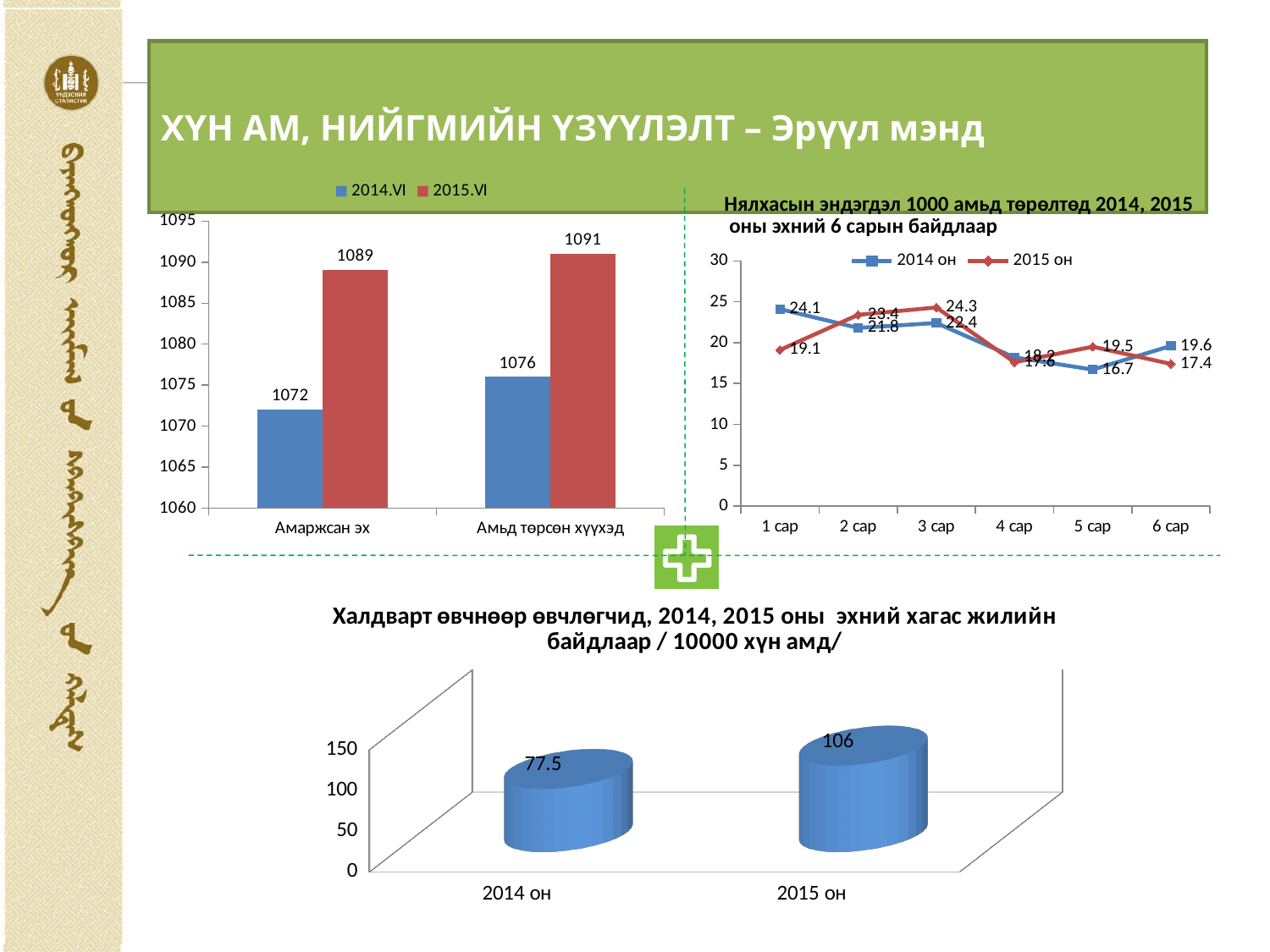
In the top-left bar chart, what is the 2015.VI value for Амаржсан эх? 1089 What kind of chart is the one titled 'Нялхасын эндэгдэл 1000 амьд төрөлтөд 2014, 2015 оны эхний 6 сарын байдлаар'? line chart In the top-left bar chart, how many series does the legend list? 2 In the top-left bar chart, what is the 2014.VI value for Амьд төрсөн хүүхэд? 1076 In the chart titled 'Халдварт өвчнөөр өвчлөгчид, 2014, 2015 оны эхний хагас жилийн байдлаар / 10000 хүн амд/', what is the value for 2015 он? 106 In the chart titled 'Нялхасын эндэгдэл 1000 амьд төрөлтөд 2014, 2015 оны эхний 6 сарын байдлаар', how many months are shown on the x axis? 6 In the chart titled 'Нялхасын эндэгдэл 1000 амьд төрөлтөд 2014, 2015 оны эхний 6 сарын байдлаар', in which month is the 2014 он value lowest? 5 сар In the top-left bar chart, which series has the higher value for Амьд төрсөн хүүхэд, 2014.VI or 2015.VI? 2015.VI In the chart titled 'Нялхасын эндэгдэл 1000 амьд төрөлтөд 2014, 2015 оны эхний 6 сарын байдлаар', what is the 2014 он value for 5 сар? 16.7 In the chart titled 'Нялхасын эндэгдэл 1000 амьд төрөлтөд 2014, 2015 оны эхний 6 сарын байдлаар', what is the 2015 он value for 3 сар? 24.3 In the top-left bar chart, what is the difference between the 2015.VI and 2014.VI values for Амаржсан эх? 17 In the chart titled 'Халдварт өвчнөөр өвчлөгчид, 2014, 2015 оны эхний хагас жилийн байдлаар / 10000 хүн амд/', what is the difference between the 2015 он and 2014 он values? 28.5